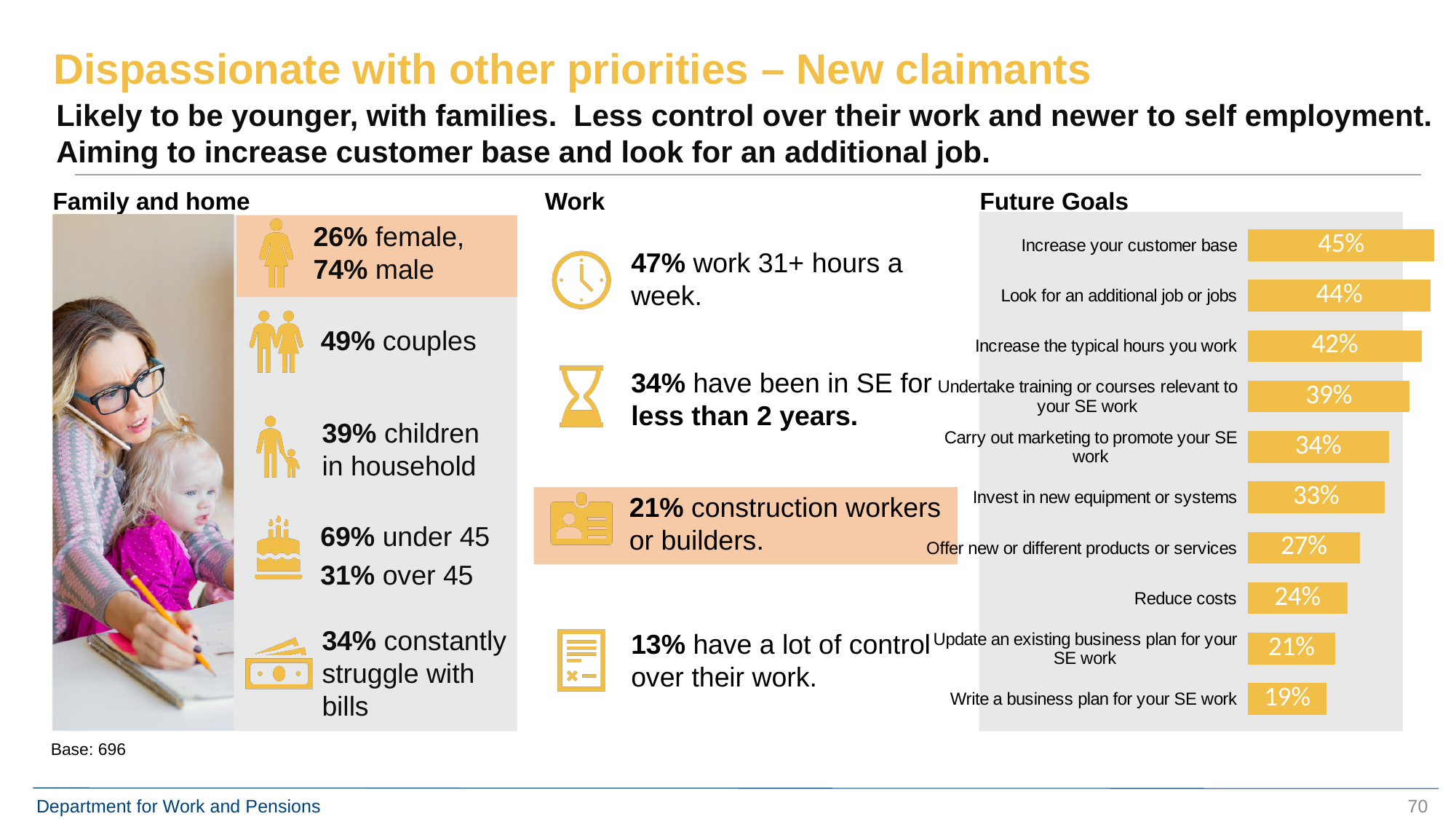
In the Future Goals chart, what is the value for 'Reduce costs'? 24% In the Future Goals chart, what is the difference between 'Increase your customer base' and 'Write a business plan for your SE work'? 26% What is the title of the chart on the right side of the slide? Future Goals How many goals are listed in the Future Goals chart? 10 In the Future Goals chart, which goal has the highest value? Increase your customer base In the Future Goals chart, what is the difference between 'Look for an additional job or jobs' and 'Reduce costs'? 20% In the Future Goals chart, which is larger: 'Carry out marketing to promote your SE work' or 'Offer new or different products or services'? Carry out marketing to promote your SE work In the Future Goals chart, what percentage of new claimants aim to increase their customer base? 45% What type of chart is the Future Goals chart? Bar chart In the Future Goals chart, what is the value for 'Undertake training or courses relevant to your SE work'? 39% In the Future Goals chart, which is larger: 'Invest in new equipment or systems' or 'Increase the typical hours you work'? Increase the typical hours you work In the Future Goals chart, which goal has the lowest value? Write a business plan for your SE work